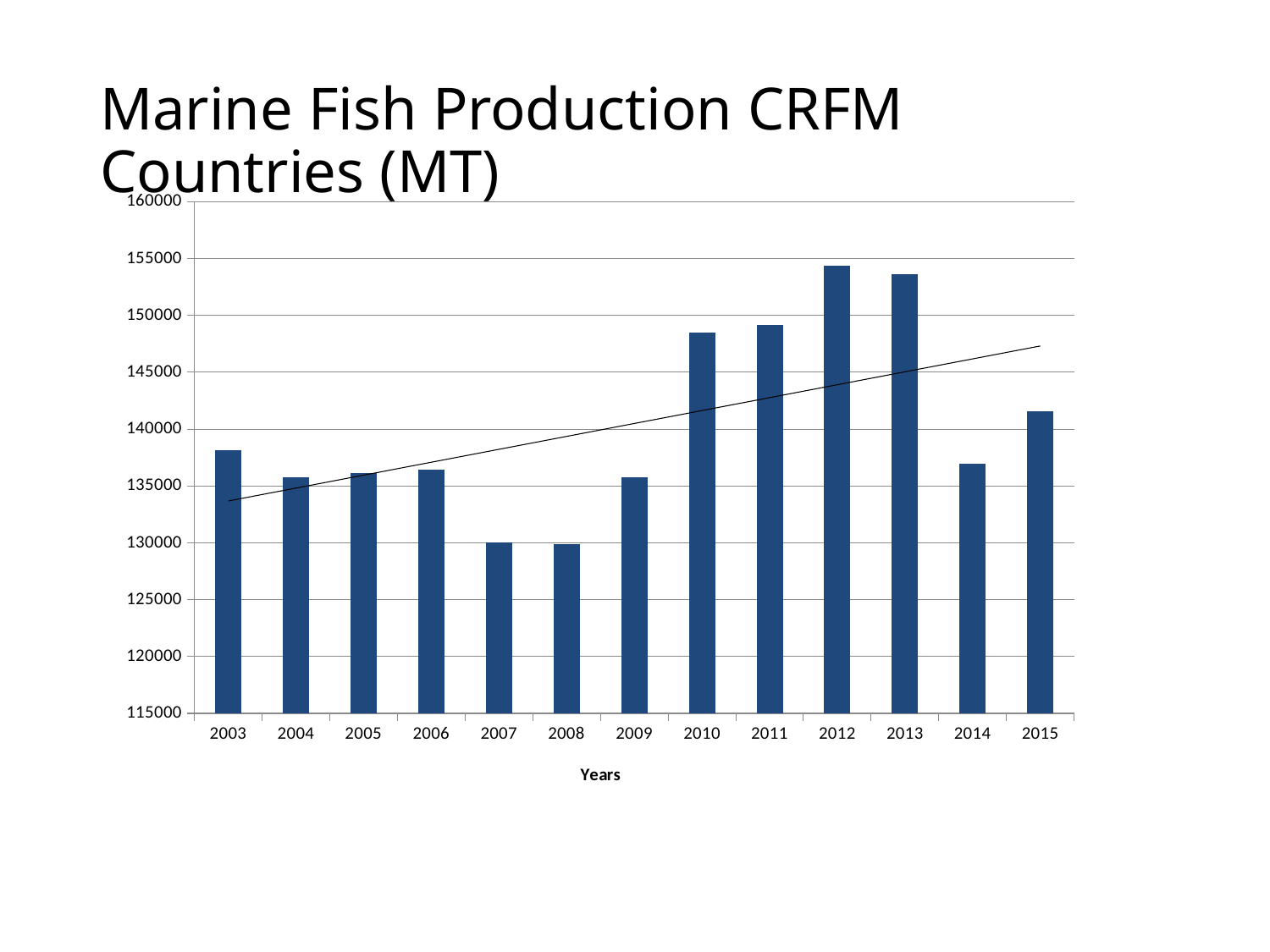
Is the value for 2014 greater or less than 140000? less Which year has the larger value, 2009 or 2010? 2010 Which year has the larger value, 2003 or 2004? 2003 What kind of chart is shown on the slide? bar chart Is the value for 2007 greater or less than 135000? less What is the label on the x axis of the chart? Years Which year has the highest marine fish production? 2012 Is the value for 2003 greater or less than 135000? greater According to the trend line, does marine fish production rise or fall from 2003 to 2015 overall? rise How many years are plotted on the x axis? 13